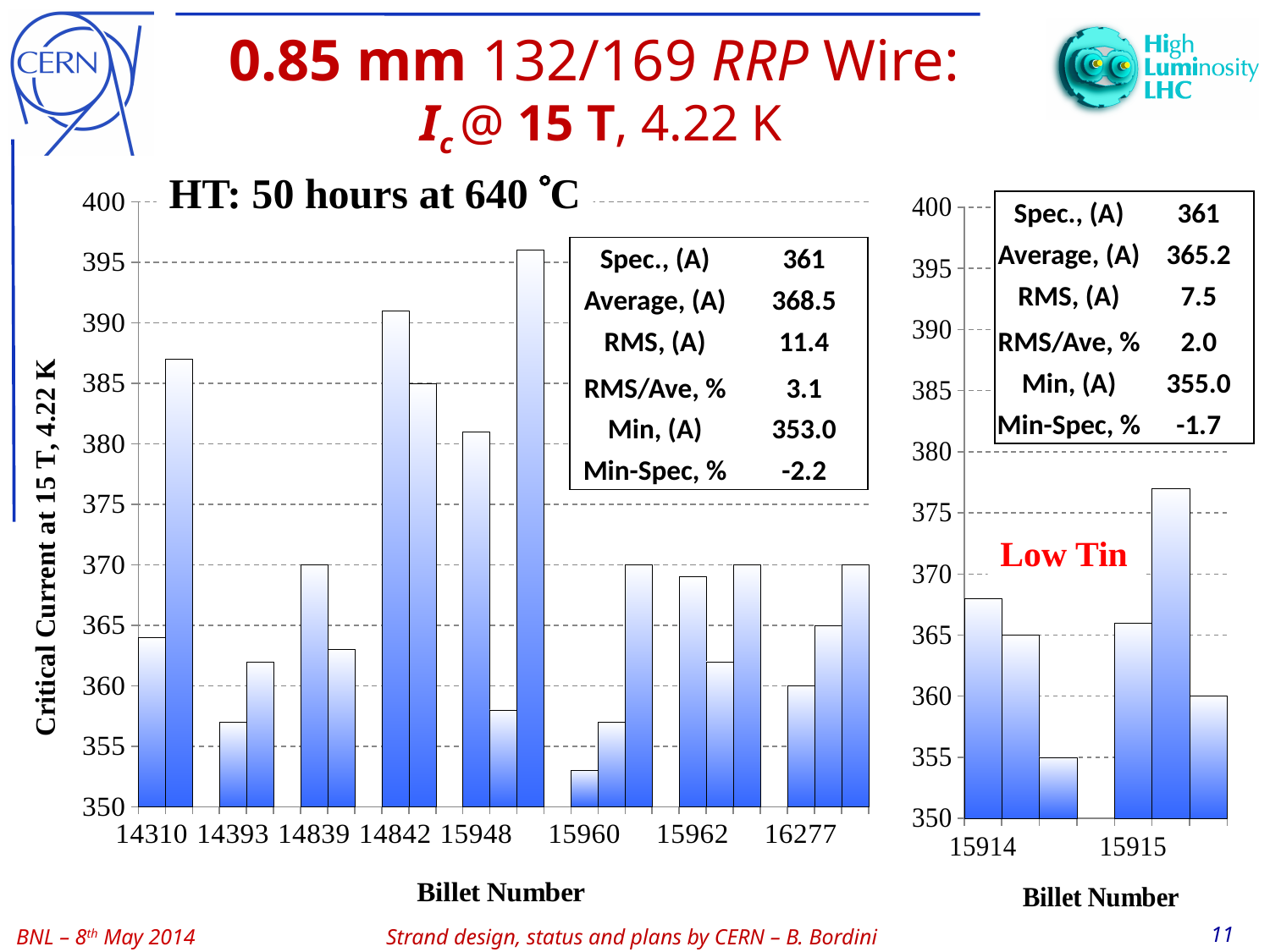
On the left chart (HT: 50 hours at 640 °C), how many billet numbers are labelled on the x axis? 8 On the right chart (Low Tin), is the tallest bar for billet 15914 taller or shorter than the tallest bar for billet 15915? shorter On the left chart (HT: 50 hours at 640 °C), is the shortest bar for billet 15960 greater or less than 355? less What kind of chart is the left chart titled 'HT: 50 hours at 640 °C'? bar chart On the left chart (HT: 50 hours at 640 °C), is the tallest bar for billet 15948 greater or less than 395? greater On the right chart (Low Tin), which billet number has the shortest bar? 15914 On the right chart (Low Tin), is the tallest bar for billet 15915 greater or less than 375? greater On the left chart (HT: 50 hours at 640 °C), which billet number has the shortest bar? 15960 On the right chart (Low Tin), how many billet numbers are labelled on the x axis? 2 On the left chart (HT: 50 hours at 640 °C), which billet number has the tallest bar? 15948 What is the Average (A) value shown in the statistics box on the left chart (HT: 50 hours at 640 °C)? 368.5 On the right chart (Low Tin), which billet number has the tallest bar? 15915